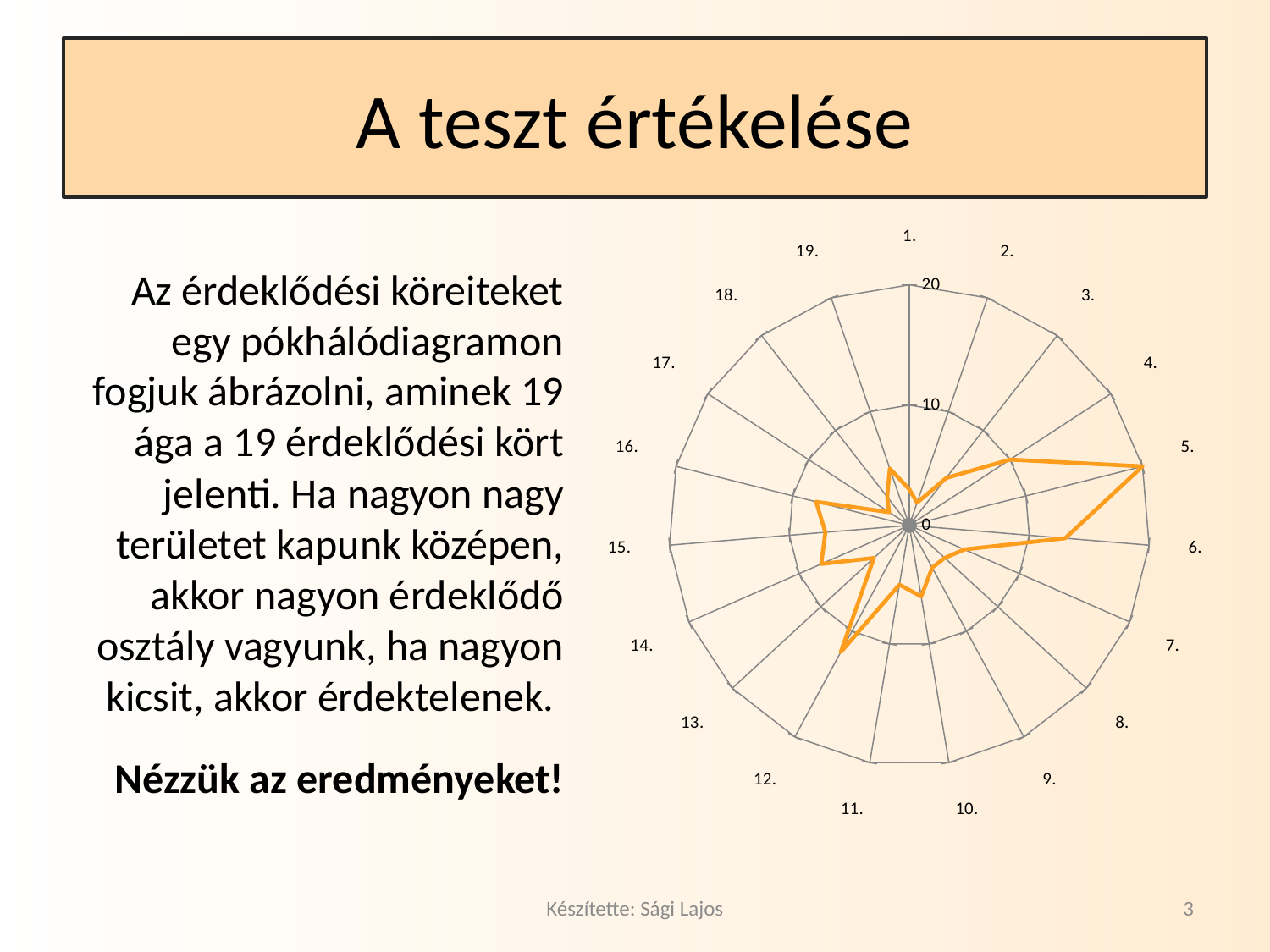
Is the value for category 16. greater or less than 10? less Is the value for category 5. greater or less than 10? greater What kind of chart is shown on the slide? radar chart Which has the larger value, category 6. or category 1.? 6. How many categories (axes) does the radar chart have? 19 Is the value for category 9. greater or less than 10? less Which category has the highest value on the radar chart? 5. What is the maximum value shown on the radar chart's axis scale? 20 Which has the larger value, category 5. or category 12.? 5.